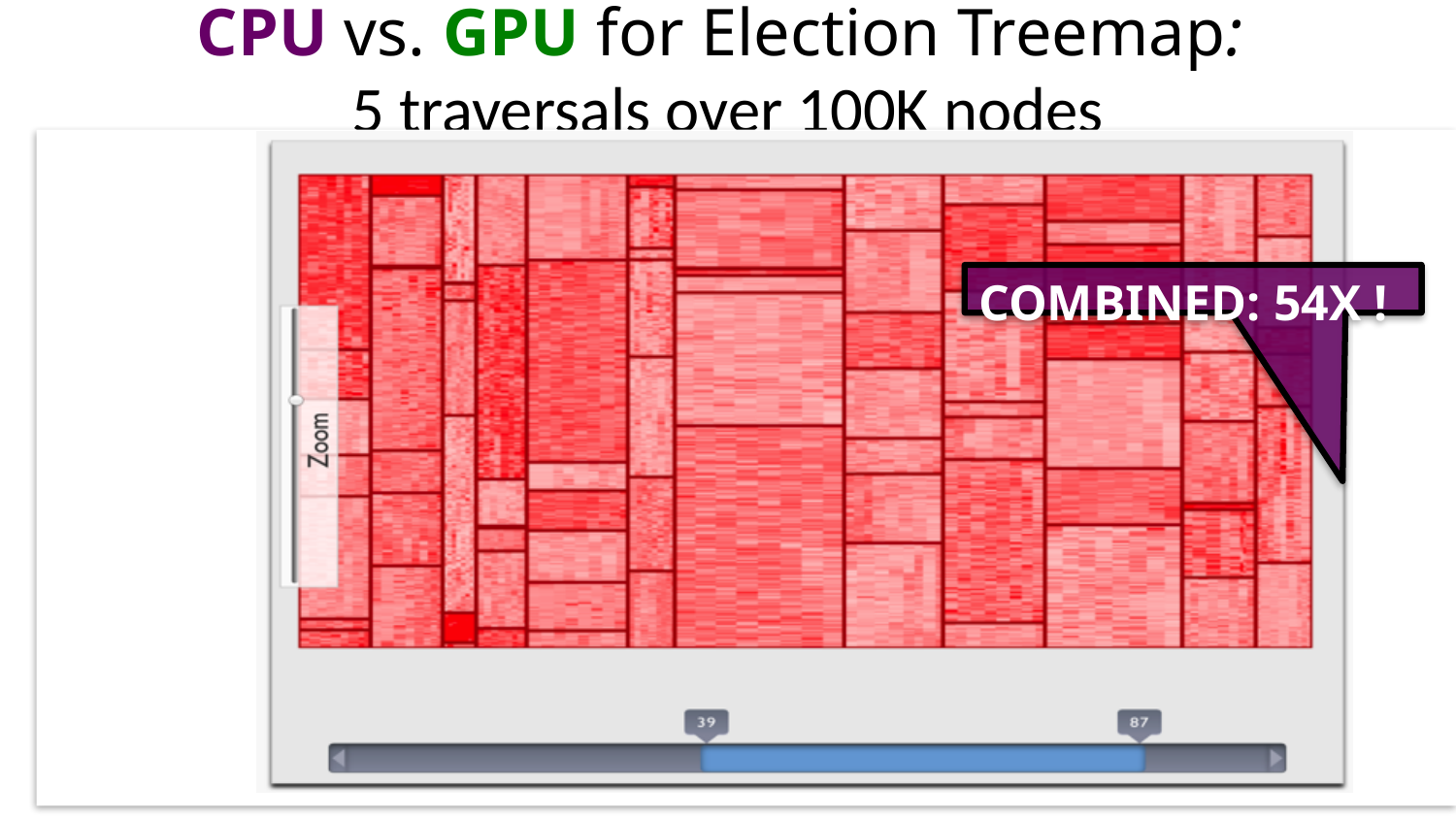
What combined speedup does the callout on the treemap report? 54X What is the upper value marked on the range slider below the treemap? 87 What is the lower value marked on the range slider below the treemap? 39 What kind of chart is shown on the slide? treemap What is the title of the chart on the slide? CPU vs. GPU for Election Treemap: 5 traversals over 100K nodes What is the difference between the upper and lower values marked on the range slider below the treemap? 48 What are the two values shown on the range slider below the treemap? 39 and 87 Which slider value is larger, the left marker or the right marker? the right marker (87)